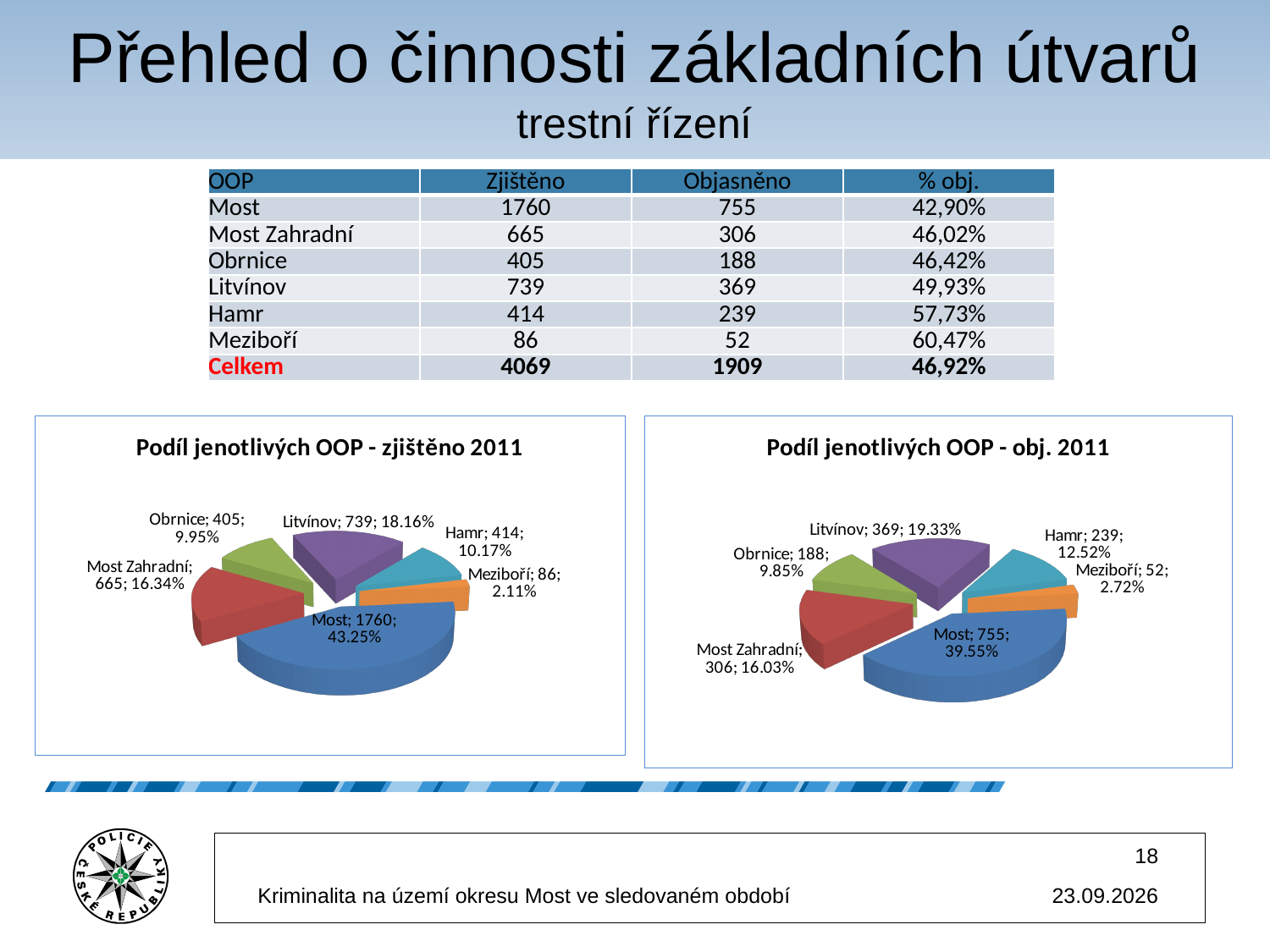
In the chart titled "Podíl jenotlivých OOP - zjištěno 2011", what value is shown for Litvínov? 739 In the chart titled "Podíl jenotlivých OOP - obj. 2011", which category has the smallest slice? Meziboří What is the title of the pie chart on the left side of the slide? Podíl jenotlivých OOP - zjištěno 2011 In the chart titled "Podíl jenotlivých OOP - obj. 2011", what value is shown for Hamr? 239 In the chart titled "Podíl jenotlivých OOP - zjištěno 2011", what is the difference between the values for Litvínov and Obrnice? 334 In the chart titled "Podíl jenotlivých OOP - obj. 2011", what is the difference between the values for Most and Most Zahradní? 449 How many slices does the chart titled "Podíl jenotlivých OOP - zjištěno 2011" have? 6 In the chart titled "Podíl jenotlivých OOP - zjištěno 2011", what share of the pie does Most Zahradní have? 16.34% What kind of chart is the chart titled "Podíl jenotlivých OOP - obj. 2011"? Pie chart In the chart titled "Podíl jenotlivých OOP - zjištěno 2011", which category has the largest slice? Most In the chart titled "Podíl jenotlivých OOP - obj. 2011", which is larger, the value for Litvínov or the value for Most Zahradní? Litvínov In the chart titled "Podíl jenotlivých OOP - obj. 2011", what share of the pie does Most have? 39.55%